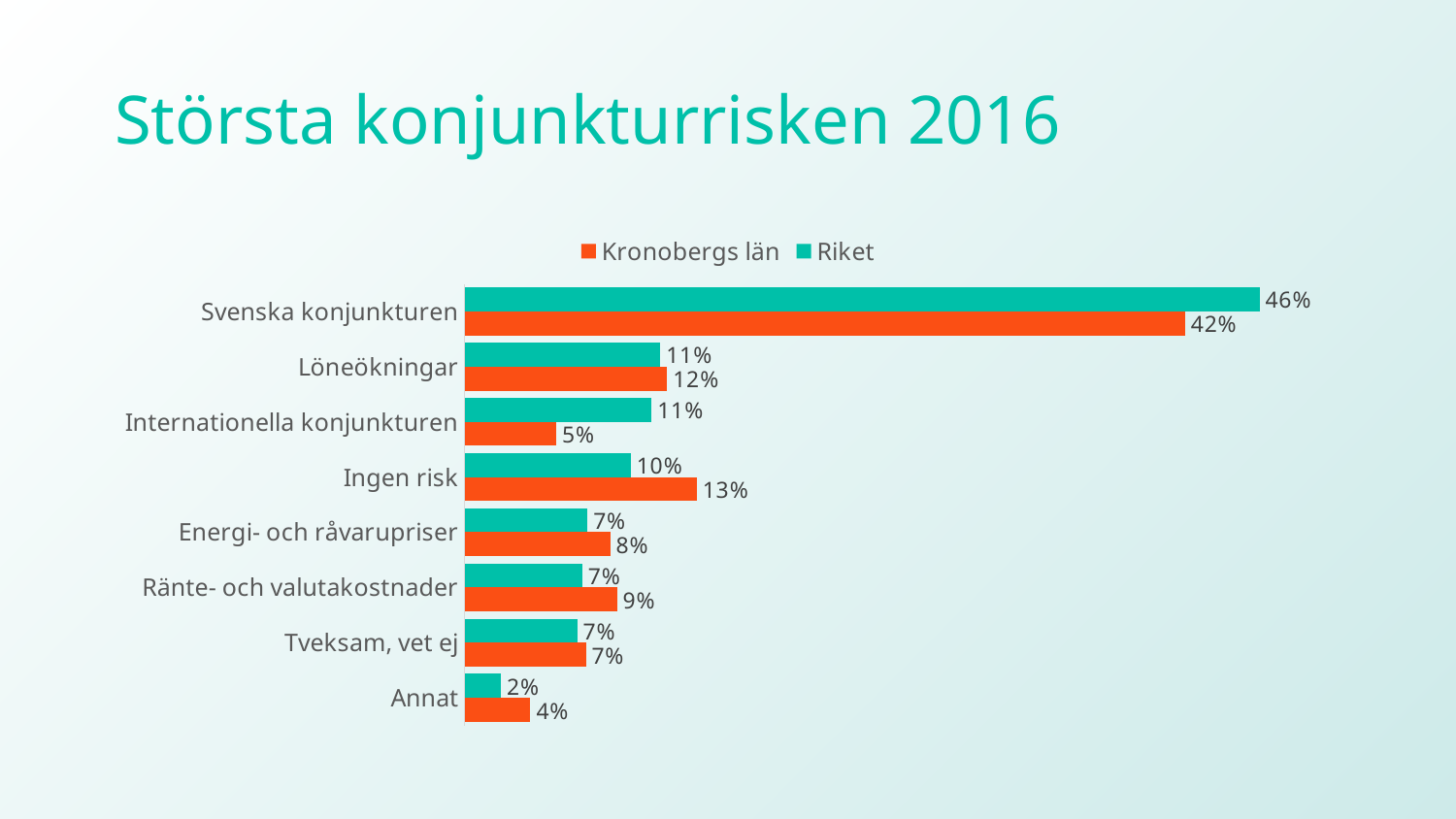
Which category has the lowest value for Kronobergs län? Annat What is the value for Riket for Internationella konjunkturen? 11% Which is larger for Ingen risk, Kronobergs län or Riket? Kronobergs län What is the title of the chart? Största konjunkturrisken 2016 What kind of chart is shown on the slide? Bar chart How many categories are shown in the chart? 8 What is the value for Kronobergs län for Ingen risk? 13% What is the difference between Riket and Kronobergs län for Internationella konjunkturen? 6% How many series does the legend list? 2 What is the value for Kronobergs län for Svenska konjunkturen? 42% What is the difference between Riket and Kronobergs län for Svenska konjunkturen? 4% Which category has the highest value for Riket? Svenska konjunkturen